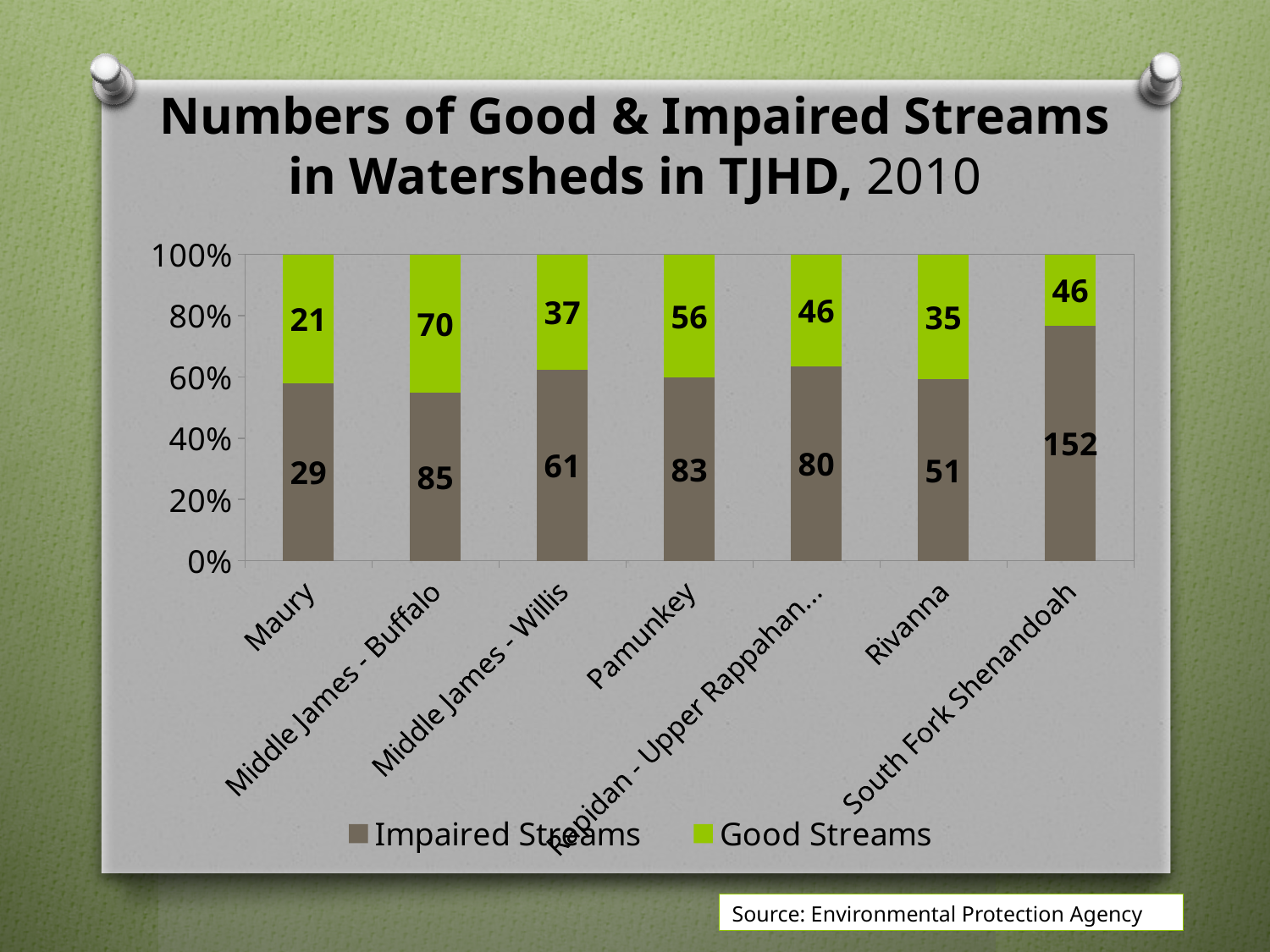
How many impaired streams are shown for Maury? 29 What is the total number of streams (impaired plus good) for Middle James - Buffalo? 155 What kind of chart is shown on the slide? Stacked bar chart How many impaired streams are shown for South Fork Shenandoah? 152 How many good streams are shown for Rivanna? 35 What is the difference between the number of impaired streams and good streams in Pamunkey? 27 Which watershed has the lowest number of good streams? Maury Which watershed has the highest number of impaired streams? South Fork Shenandoah How many series does the legend list? 2 How many good streams are shown for Middle James - Buffalo? 70 Which has more good streams, Middle James - Willis or Pamunkey? Pamunkey How many watersheds are shown on the x axis? 7